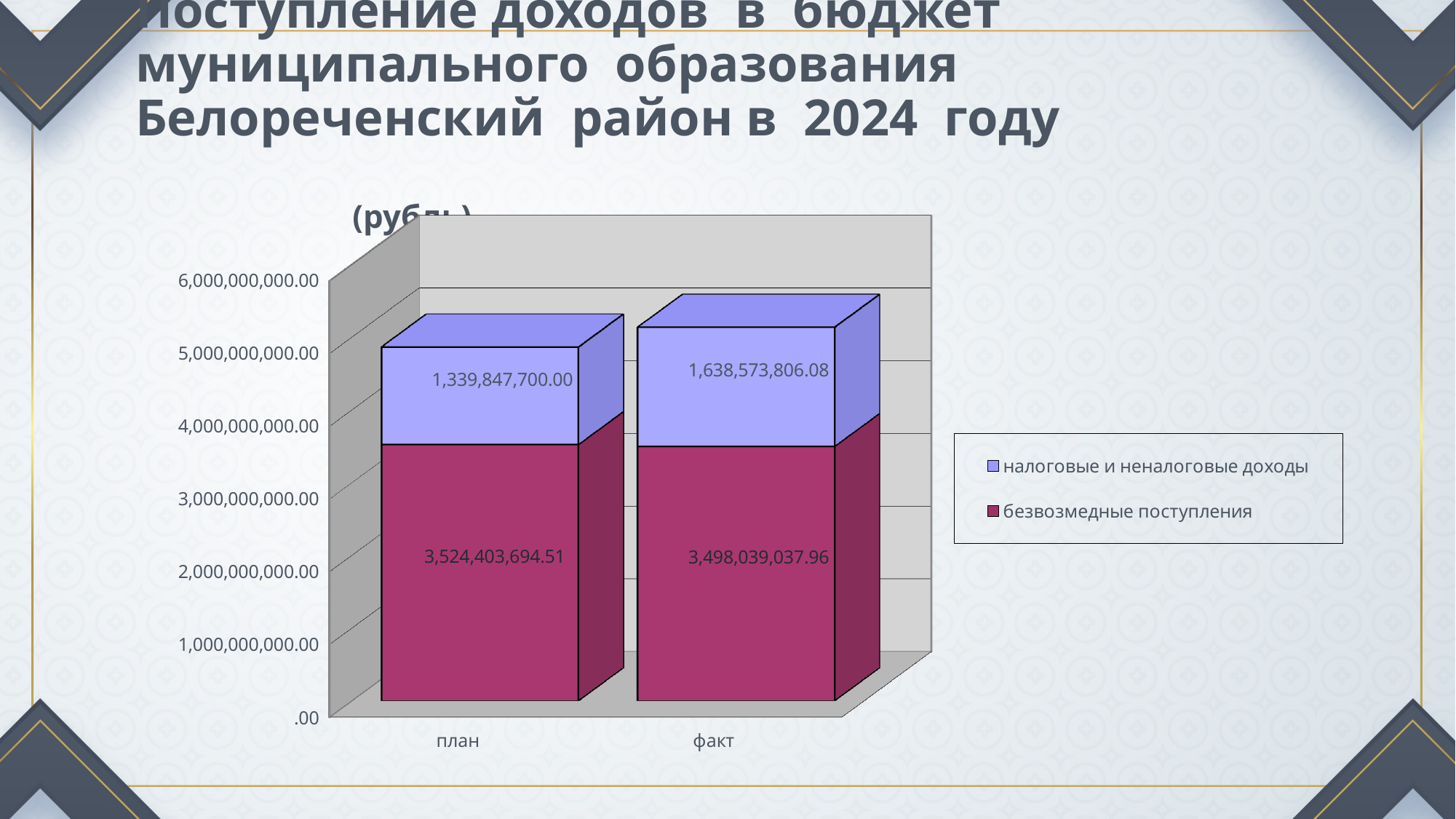
Which category has the higher value for налоговые и неналоговые доходы, план or факт? факт What is the value of безвозмедные поступления for факт? 3,498,039,037.96 What kind of chart is shown on the slide? stacked bar chart How many series does the legend list? 2 What is the value of налоговые и неналоговые доходы for факт? 1,638,573,806.08 What is the difference between the факт and план values for налоговые и неналоговые доходы? 298,726,106.08 What is the difference between the план and факт values for безвозмедные поступления? 26,364,656.55 How many categories are shown on the x axis? 2 What is the total of the stacked bar for факт? 5,136,612,844.04 What is the value of безвозмедные поступления for план? 3,524,403,694.51 What is the total of the stacked bar for план? 4,864,251,394.51 What is the value of налоговые и неналоговые доходы for план? 1,339,847,700.00